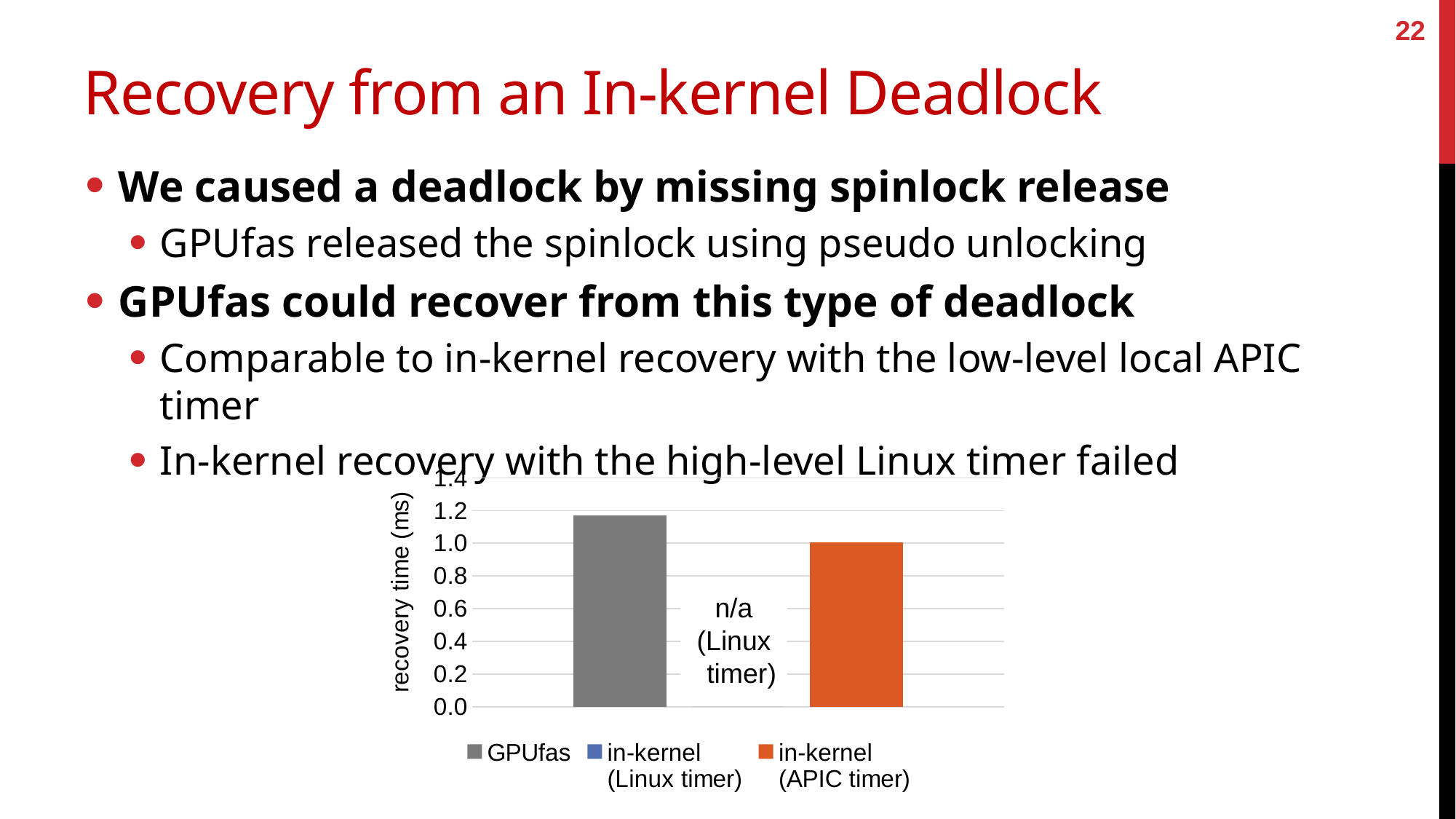
What is the label of the chart's vertical axis? recovery time (ms) How many bars are actually plotted in the chart? 2 Is the recovery time for GPUfas greater or less than 1.0 ms? greater Which has the longer recovery time, GPUfas or in-kernel (APIC timer)? GPUfas Which series has the highest recovery time in the chart? GPUfas What kind of chart is shown on the slide? bar chart Is the recovery time for in-kernel (APIC timer) greater or less than 1.2 ms? less How many series does the chart's legend list? 3 Is the recovery time for in-kernel (APIC timer) greater or less than 0.8 ms? greater What is shown in the chart in place of a bar for in-kernel (Linux timer)? n/a